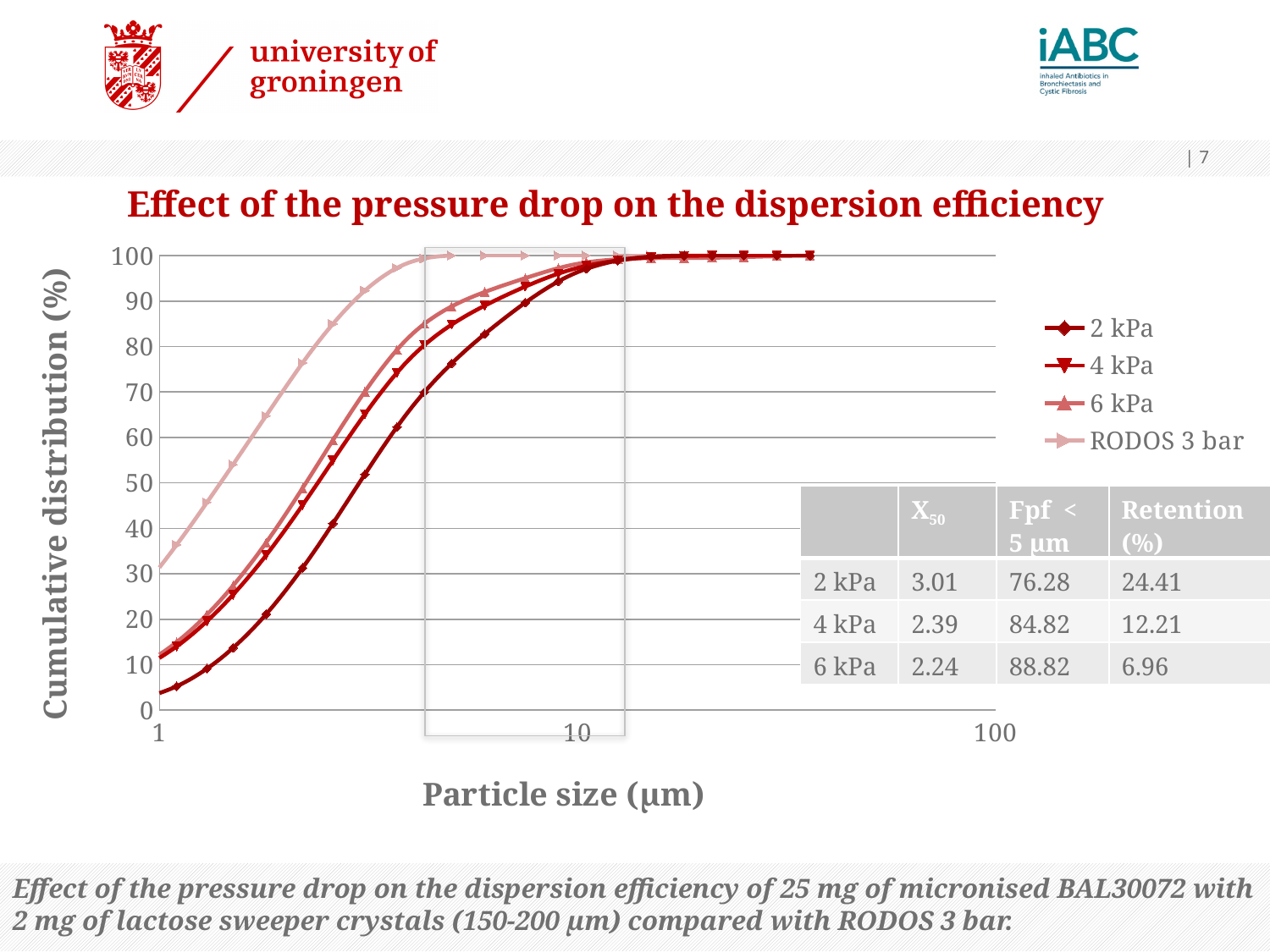
How many series does the chart legend list? 4 Which series reaches 100% cumulative distribution at the smallest particle size? RODOS 3 bar At a particle size of 2 µm, which series has the larger cumulative distribution, 6 kPa or 2 kPa? 6 kPa At a particle size of 1 µm, is the cumulative distribution for the 2 kPa series greater or less than 10? less Which series has the lowest cumulative distribution at a particle size of 1 µm? 2 kPa Which series has the highest cumulative distribution at a particle size of 1 µm? RODOS 3 bar What kind of chart is shown on the slide? line chart What is the label of the y axis of the chart? Cumulative distribution (%) What is the title of the chart? Effect of the pressure drop on the dispersion efficiency At a particle size of 10 µm, is the cumulative distribution for the 2 kPa series greater or less than 90? greater At a particle size of 1 µm, is the cumulative distribution for the RODOS 3 bar series greater or less than 20? greater Do the values of the 2 kPa series rise or fall as particle size increases along the x axis? rise